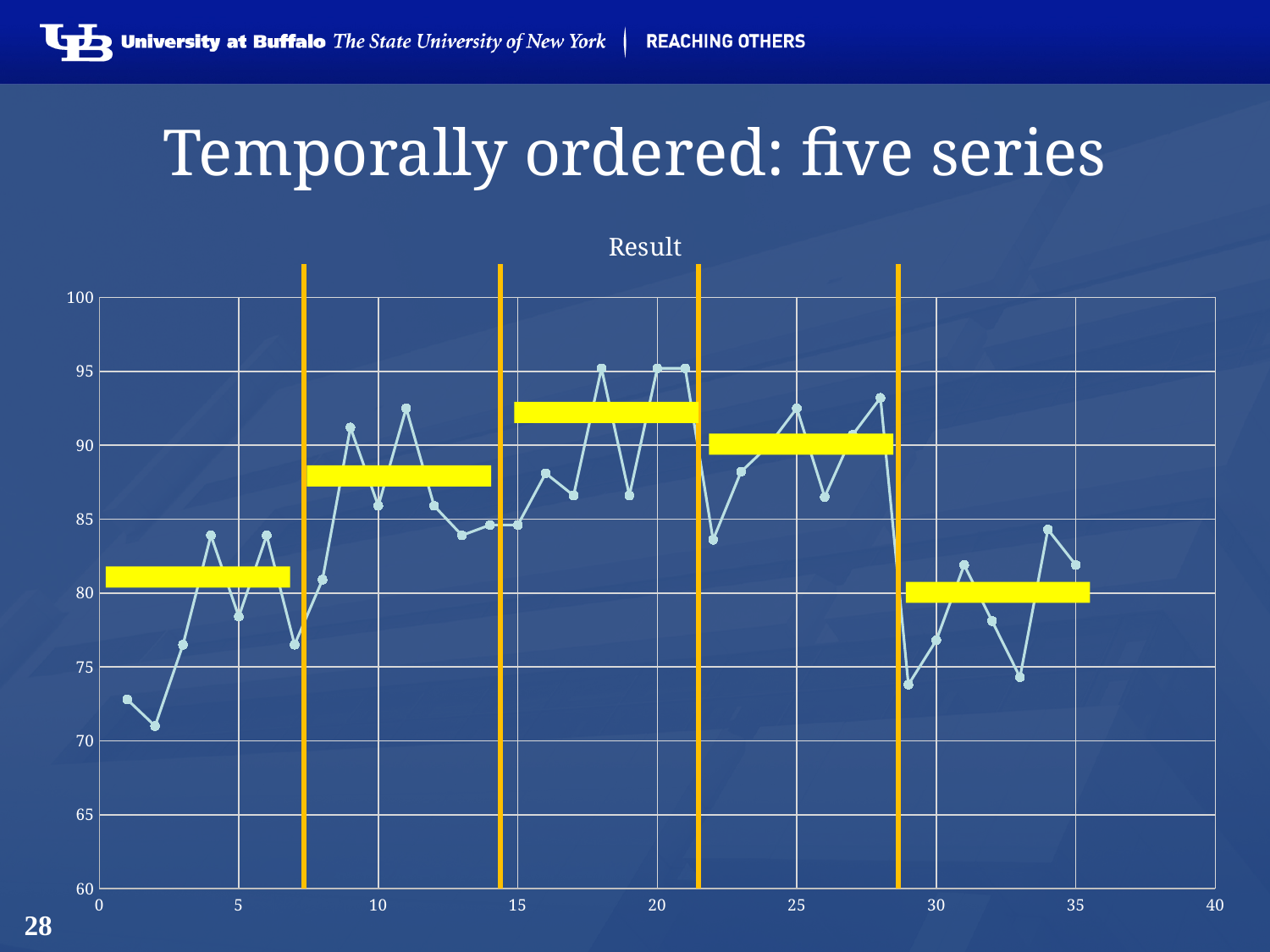
Which is larger, the value at x = 4 or the value at x = 2? x = 4 Do the values rise or fall from x = 31 to x = 33? fall Is the value at x = 2 greater or less than 75? less Which is larger, the value at x = 18 or the value at x = 22? x = 18 What kind of chart is shown on the slide? line chart How many yellow horizontal bars are drawn on the chart? 5 Is the value at x = 25 greater or less than 90? greater Is the value at x = 11 greater or less than 90? greater At which x value does the lowest point on the chart occur? 2 What is the title of the chart? Result